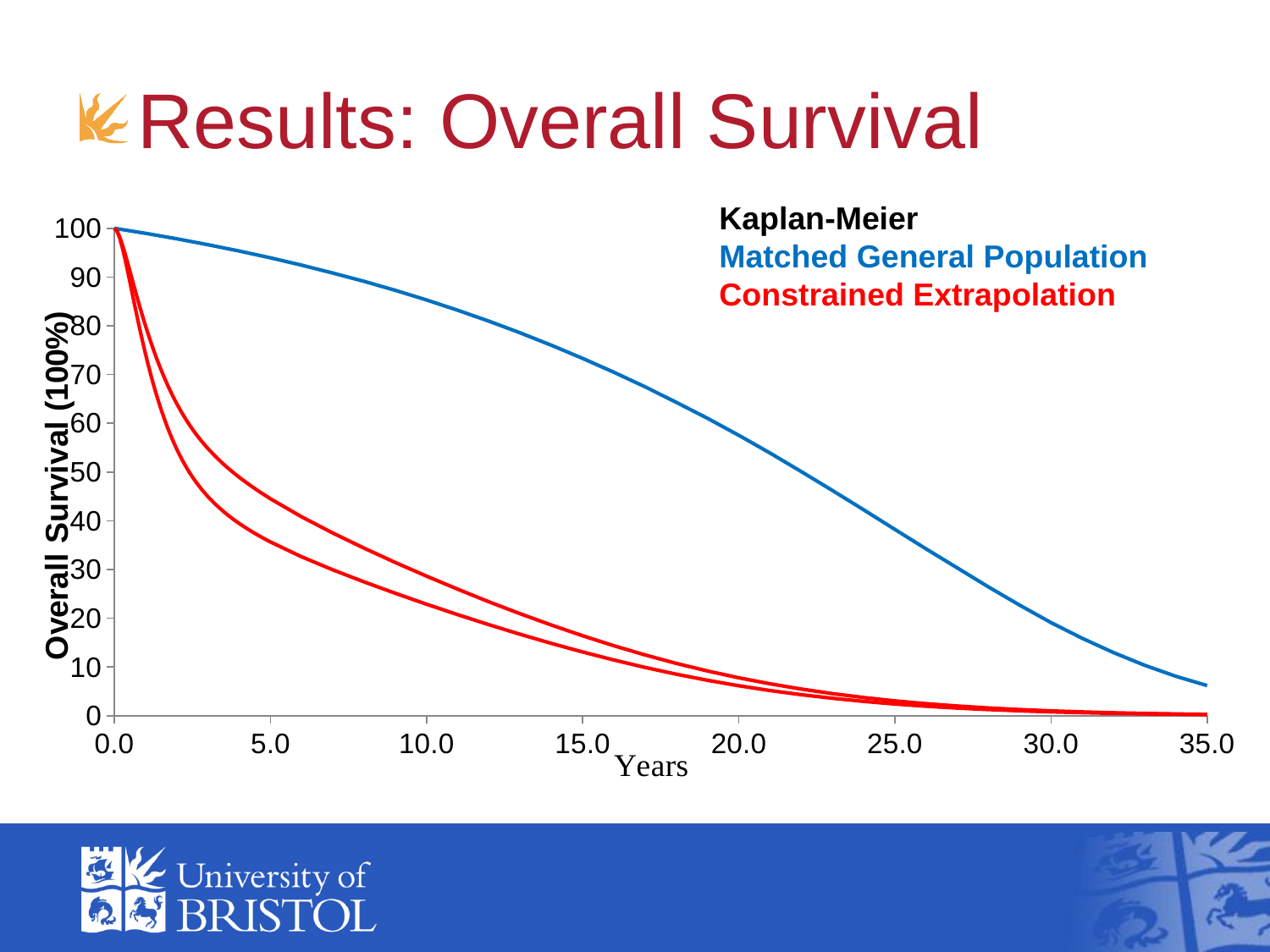
What is the overall survival value of the curves at 0.0 years? 100 What is the title of the slide containing the chart? Results: Overall Survival Is the Matched General Population value at 30.0 years greater or less than 20? less What is the label of the y axis? Overall Survival (100%) Are the Constrained Extrapolation values at 20.0 years greater or less than 10? less Is the Matched General Population value at 10.0 years greater or less than 80? greater Do the survival curves rise or fall as years increase along the x axis? Fall At 15.0 years, which is larger: the Matched General Population curve or the Constrained Extrapolation curves? Matched General Population What kind of chart is shown on the slide? Line chart How many entries does the legend list? 3